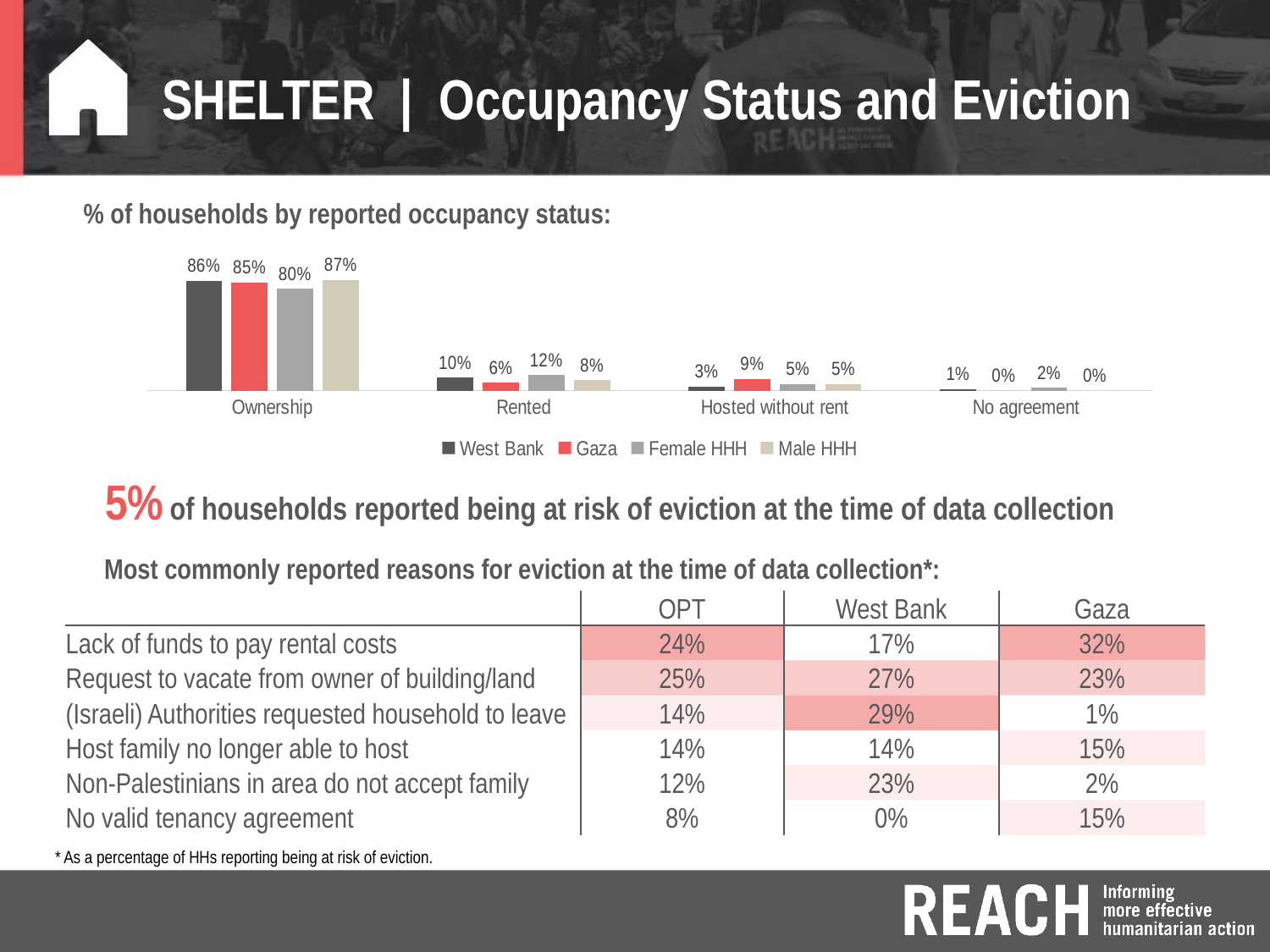
What is the difference between the Female HHH and Male HHH values in the Ownership category? 7% What kind of chart is used to show % of households by reported occupancy status? Bar chart What is the value for Female HHH in the Rented category? 12% What percentage of West Bank households reported Ownership as their occupancy status? 86% Which series has the lowest value in the Rented category? Gaza What is the value for Gaza in the Hosted without rent category? 9% How many series does the legend list? 4 How many occupancy status categories are shown on the x axis? 4 What is the value for Male HHH in the No agreement category? 0% Which series has the highest value in the Ownership category? Male HHH Which series is shown in red in the chart legend? Gaza In the Hosted without rent category, which is larger: the West Bank value or the Gaza value? Gaza